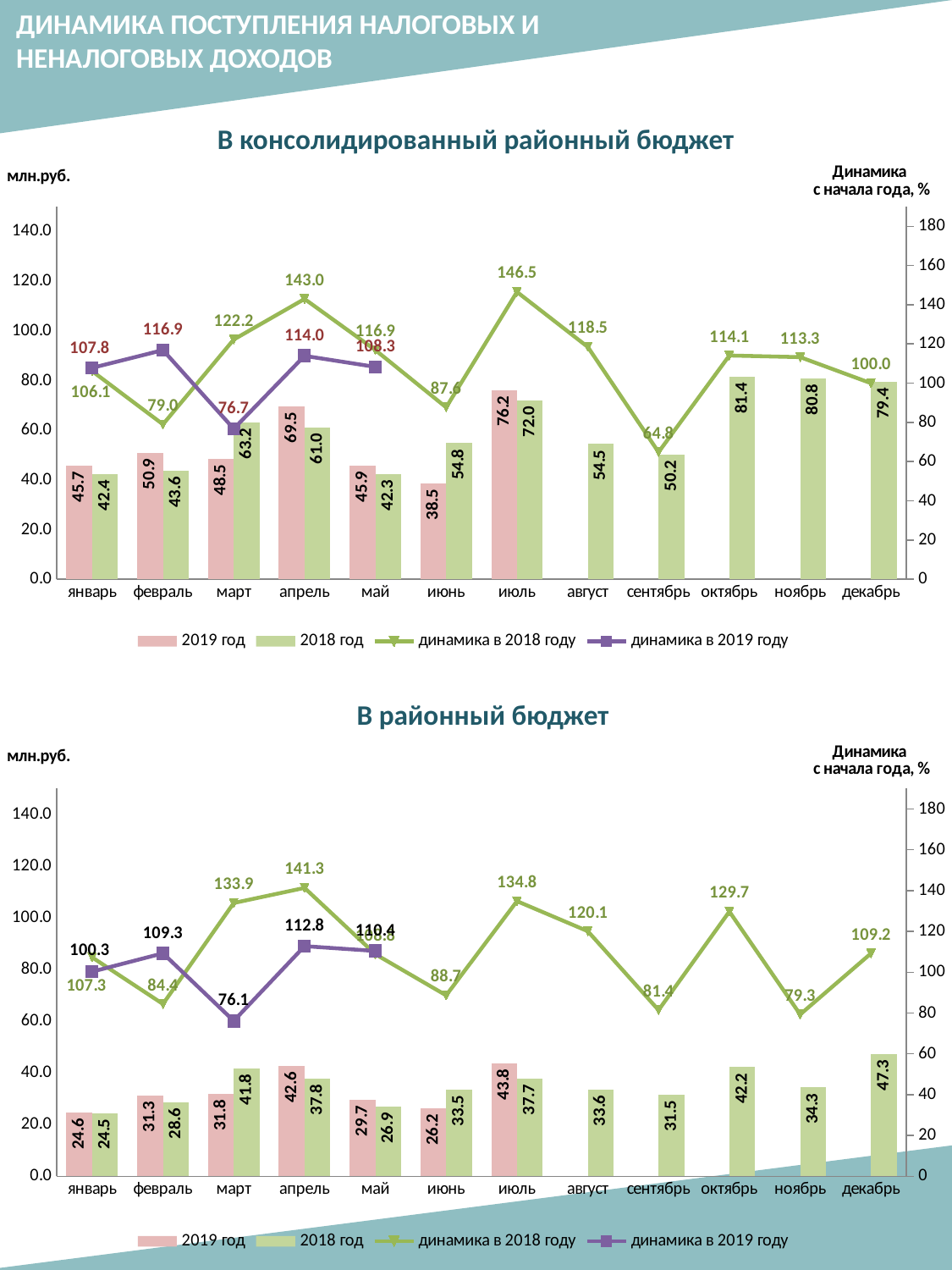
In the chart 'В консолидированный районный бюджет', what is the value of the 2019 год bar for июль? 76.2 In the chart 'В районный бюджет', how many months are shown on the x axis? 12 What kind of chart is 'В районный бюджет'? Combined bar and line chart In the chart 'В консолидированный районный бюджет', how many series does the legend list? 4 In the chart 'В консолидированный районный бюджет', what is the value of the 2018 год bar for октябрь? 81.4 In the chart 'В районный бюджет', what is the value of the 2018 год bar for декабрь? 47.3 In the chart 'В районный бюджет', which month has the highest 2019 год bar? июль In the chart 'В консолидированный районный бюджет', which month has the lowest value on the 'динамика в 2018 году' line? сентябрь In the chart 'В консолидированный районный бюджет', what is the difference between the 2019 год and 2018 год bars for апрель? 8.5 In the chart 'В консолидированный районный бюджет', which month has the highest value on the 'динамика в 2018 году' line? июль In the chart 'В районный бюджет', what is the value of the 'динамика в 2019 году' line for март? 76.1 In the chart 'В районный бюджет', which is larger for июнь: the 2019 год bar or the 2018 год bar? 2018 год